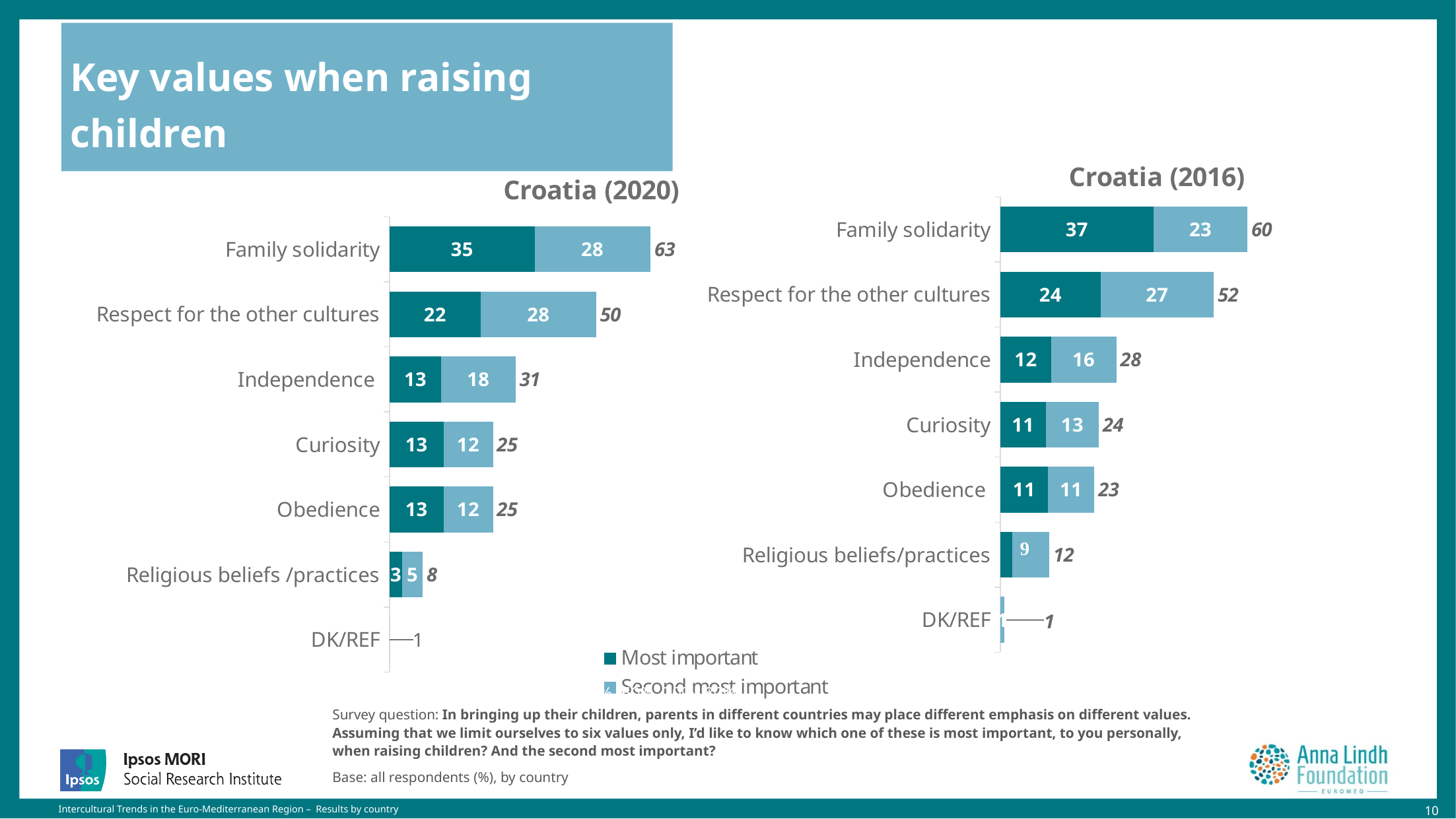
In the Croatia (2020) chart, which category has the lowest total, excluding DK/REF? Religious beliefs /practices In the Croatia (2020) chart, what is the 'Most important' value for Family solidarity? 35 How many categories are shown in the Croatia (2020) chart? 7 In the Croatia (2020) chart, what is the difference between the totals for Family solidarity and Respect for the other cultures? 13 In the Croatia (2016) chart, what is the difference between the 'Most important' values for Family solidarity and Independence? 25 What kind of chart is the Croatia (2016) chart? Stacked bar chart In the Croatia (2020) chart, what is the total for Respect for the other cultures? 50 In the Croatia (2016) chart, which category has the highest total? Family solidarity In the Croatia (2016) chart, what is the 'Second most important' value for Respect for the other cultures? 27 Which is larger: the total for Independence in the Croatia (2020) chart or in the Croatia (2016) chart? Croatia (2020) In the Croatia (2016) chart, what is the 'Second most important' value for Religious beliefs/practices? 9 How many series does the legend list? 2